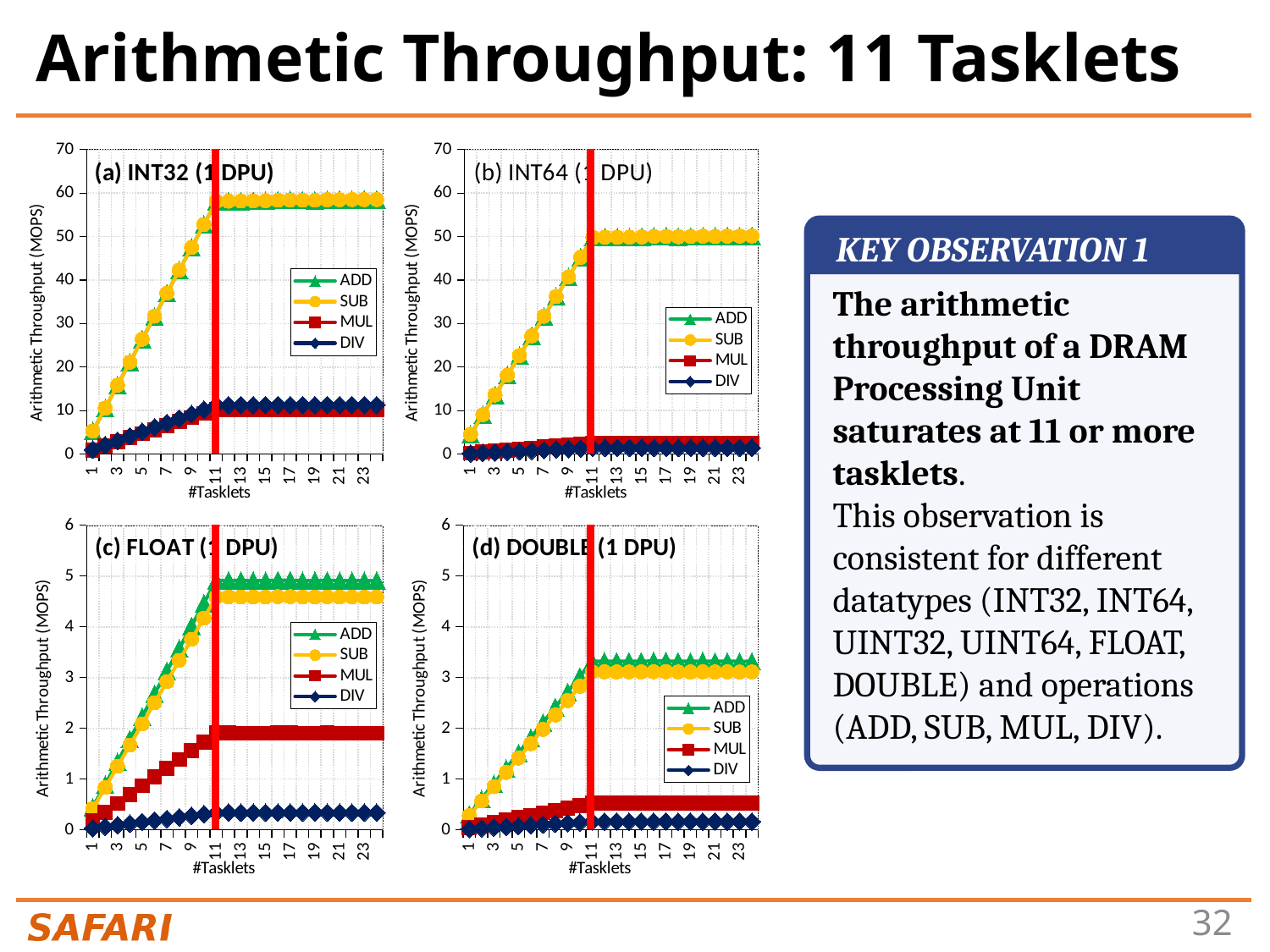
At what number of tasklets is the red vertical line drawn in each chart? 11 In chart (a) INT32 (1 DPU), does the ADD throughput rise or fall as the number of tasklets increases from 1 to 11? rise How many series does the legend of chart (b) INT64 (1 DPU) list? 4 In chart (a) INT32 (1 DPU), is the MUL value at 23 tasklets greater or less than 20? less What kind of chart is chart (a) INT32 (1 DPU)? line chart How many charts are shown on the slide? 4 In chart (b) INT64 (1 DPU), is the SUB value at 23 tasklets greater or less than 40? greater In chart (a) INT32 (1 DPU), is the ADD value at 23 tasklets greater or less than 50? greater In chart (c) FLOAT (1 DPU), which series has the lowest throughput at 23 tasklets? DIV In chart (c) FLOAT (1 DPU), which is larger at 23 tasklets, MUL or DIV? MUL